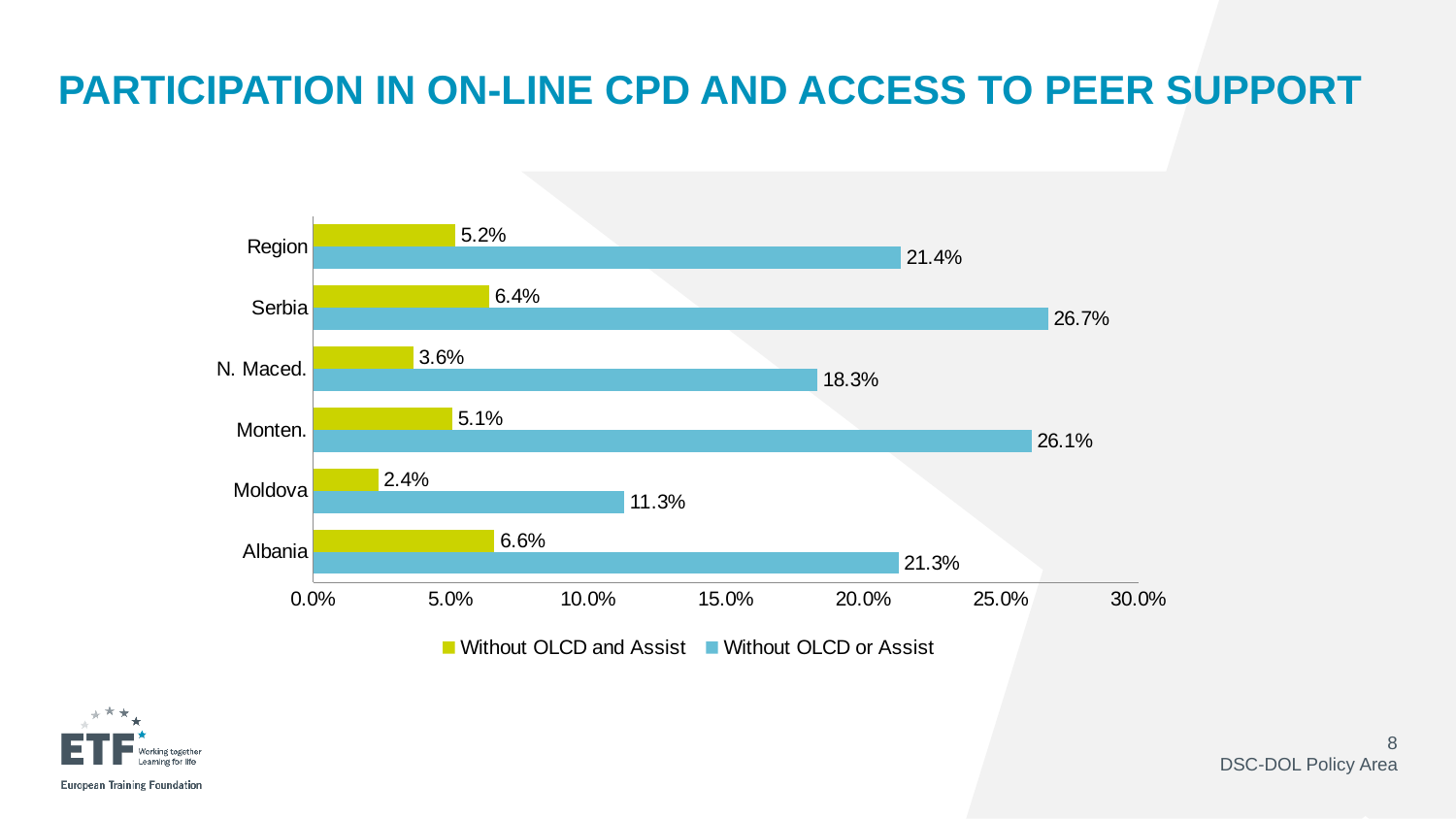
How many series does the legend list? 2 What is the value for Serbia in the 'Without OLCD or Assist' series? 26.7% What kind of chart is shown on the slide? Bar chart What is the title of the chart on the slide? PARTICIPATION IN ON-LINE CPD AND ACCESS TO PEER SUPPORT How many categories are shown on the chart? 6 Which is larger: the 'Without OLCD or Assist' value for Monten. or for N. Maced.? Monten. What is the difference between the 'Without OLCD or Assist' and 'Without OLCD and Assist' values for Albania? 14.7% Which category has the highest value in the 'Without OLCD or Assist' series? Serbia What is the value for Region in the 'Without OLCD or Assist' series? 21.4% What is the value for Moldova in the 'Without OLCD and Assist' series? 2.4% Which category has the lowest value in the 'Without OLCD and Assist' series? Moldova Is the 'Without OLCD or Assist' value for Moldova greater or less than 15.0%? less